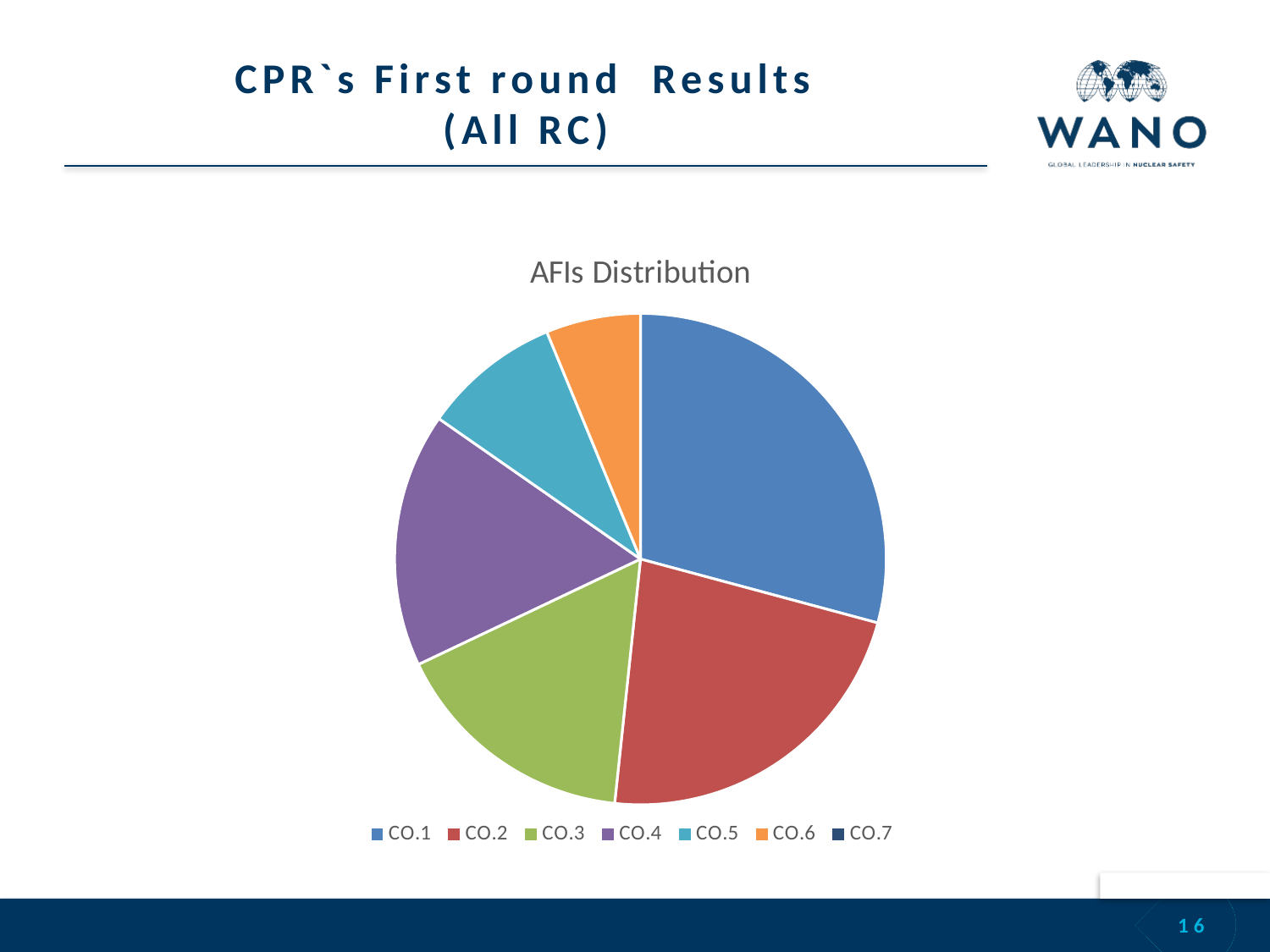
Which slice is larger, CO.1 or CO.2? CO.1 How many entries does the chart's legend list? 7 What colour is the CO.1 slice in the pie chart? blue Which slice is larger, CO.4 or CO.6? CO.4 Which slice is larger, CO.2 or CO.4? CO.2 What is the title of the chart? AFIs Distribution What kind of chart is shown on the slide? pie chart How many slices are visible in the pie chart? 6 Which category has the largest slice of the pie? CO.1